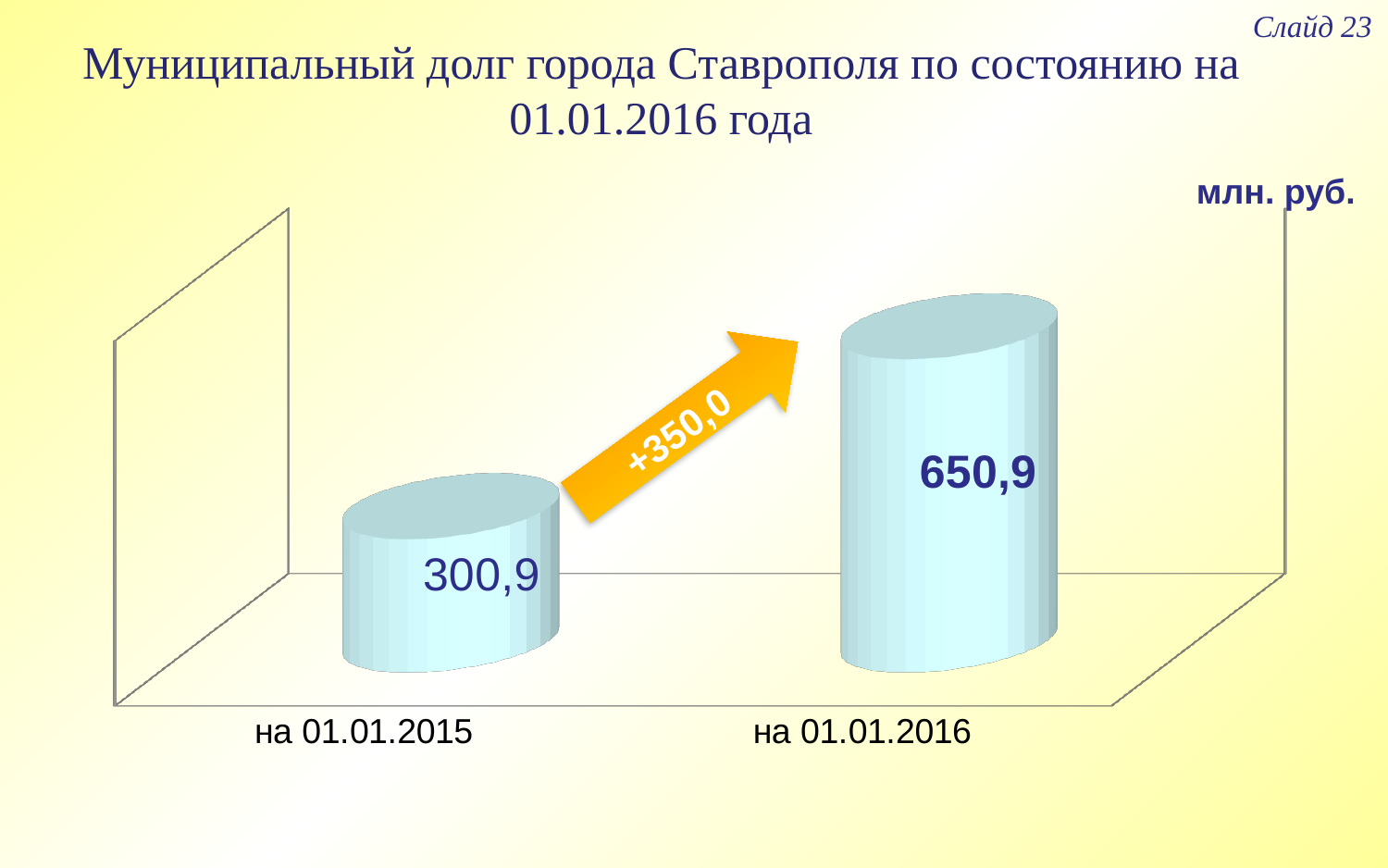
Which category has the lowest value on the chart? на 01.01.2015 What is the difference between the values for на 01.01.2016 and на 01.01.2015? 350,0 What kind of chart is shown on the slide? bar chart How many categories are plotted on the chart? 2 What is the municipal debt value shown for на 01.01.2016? 650,9 What change is written on the arrow between the two bars? +350,0 Which category has the higher value, на 01.01.2015 or на 01.01.2016? на 01.01.2016 What unit of measurement is indicated on the chart? млн. руб. Is the value for на 01.01.2016 larger or smaller than the value for на 01.01.2015? larger What is the municipal debt value shown for на 01.01.2015? 300,9 Do the values rise or fall from на 01.01.2015 to на 01.01.2016? rise